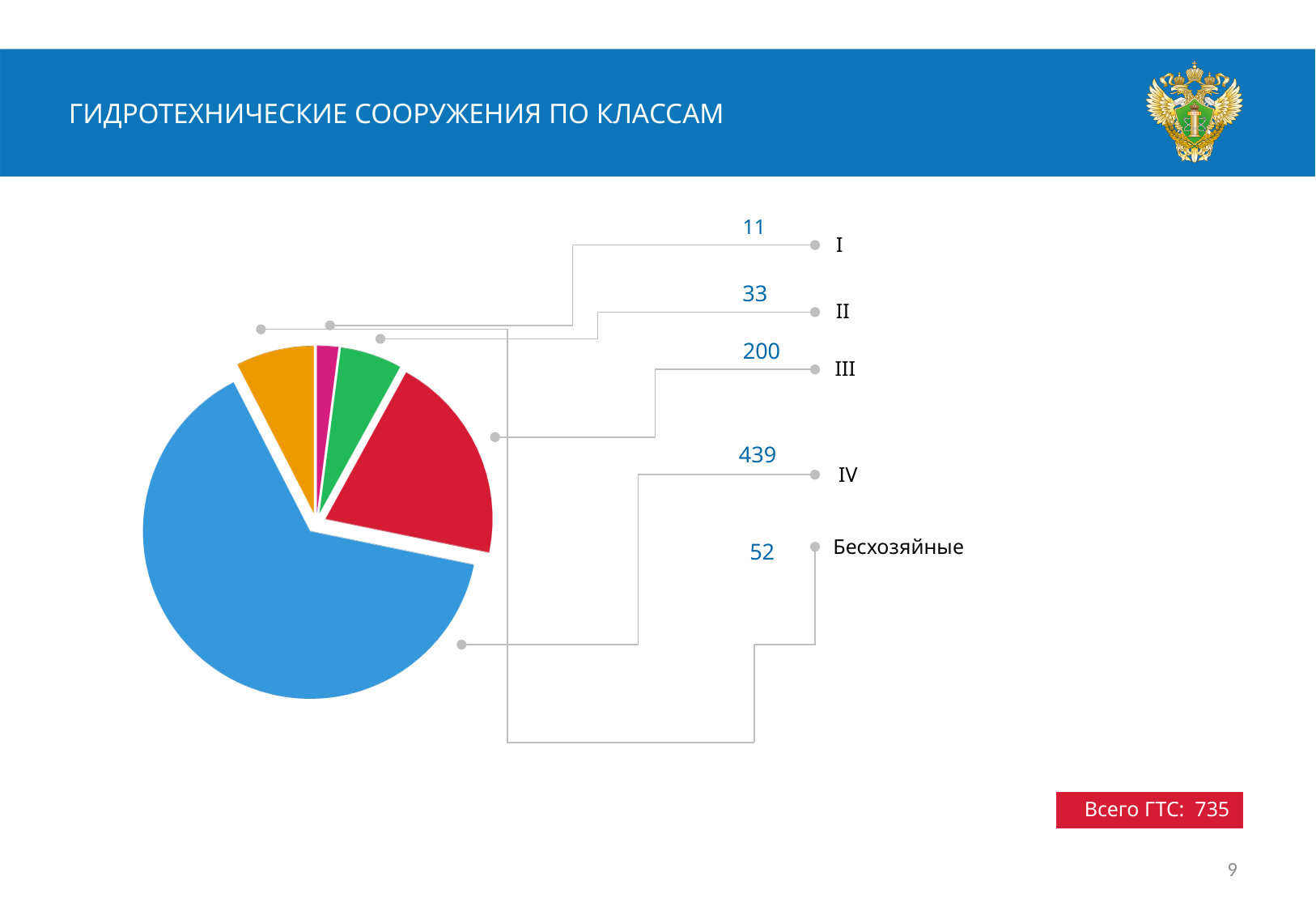
Which category has the largest slice of the pie? IV What is the difference between the values for class IV and class III? 239 What is the value for class I? 11 What is the value for class IV? 439 What is the difference between the values for Бесхозяйные and class II? 19 What is the value for Бесхозяйные? 52 What kind of chart is shown on the slide? pie chart What total number of ГТС is stated on the slide? 735 How many categories does the pie chart have? 5 What is the value for class III? 200 Which is larger, the value for class II or the value for Бесхозяйные? Бесхозяйные Which category has the smallest slice of the pie? I